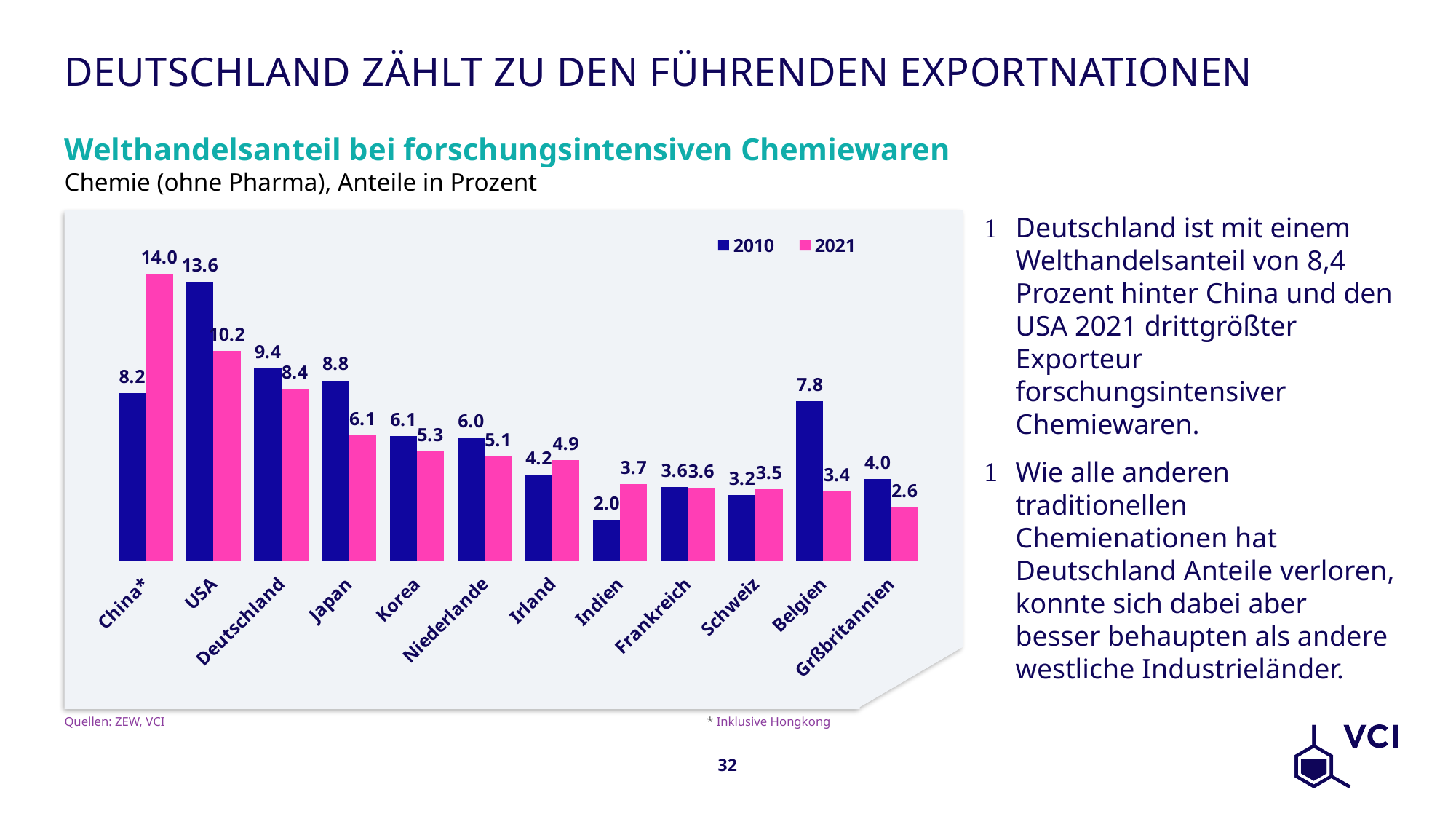
How many series does the legend list? 2 What was Deutschland's world trade share in 2021? 8.4 What was the value for USA in 2010? 13.6 How many countries are shown on the x axis? 12 What is the difference between China*'s 2021 value and its 2010 value? 5.8 Which country had the lowest value in 2010? Indien What was the value for Belgien in 2021? 3.4 Which colour represents the 2021 series in the chart? Pink Which country had the highest value in 2021? China* What kind of chart is shown on the slide? Bar chart Which is larger: Irland's 2021 value or Korea's 2021 value? Korea's 2021 value By how much did the value for USA fall from 2010 to 2021? 3.4